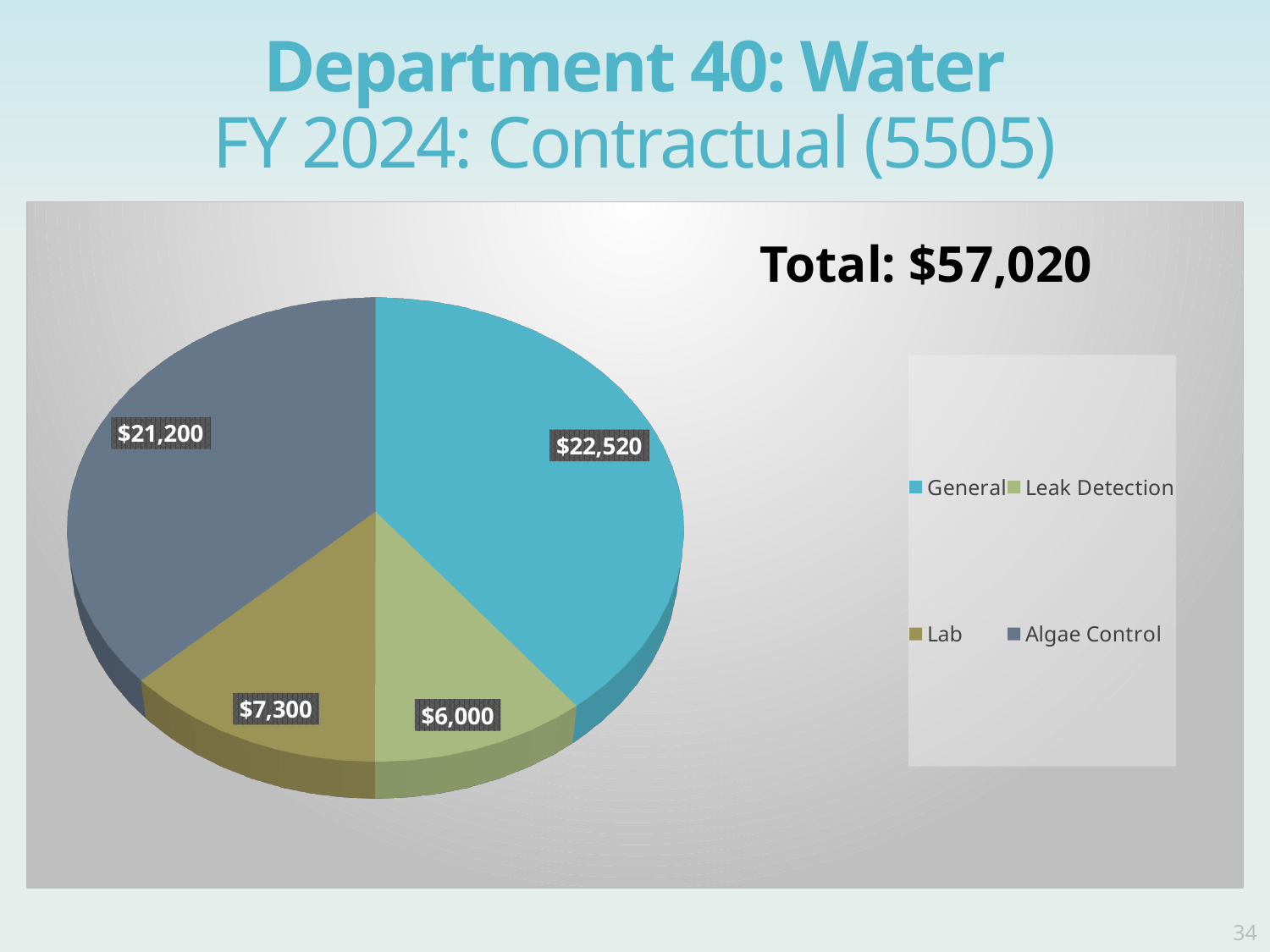
What is the value for General? $22,520 What kind of chart is shown on the slide? Pie chart Which is larger, Lab or Leak Detection? Lab What is the value for Leak Detection? $6,000 Which category has the smallest slice? Leak Detection What is the difference between the Lab and Leak Detection values? $1,300 What is the value for Algae Control? $21,200 Which category has the largest slice? General What is the difference between the General and Algae Control values? $1,320 How many categories does the pie chart show? 4 What is the value for Lab? $7,300 What total is printed on the slide for the chart? $57,020